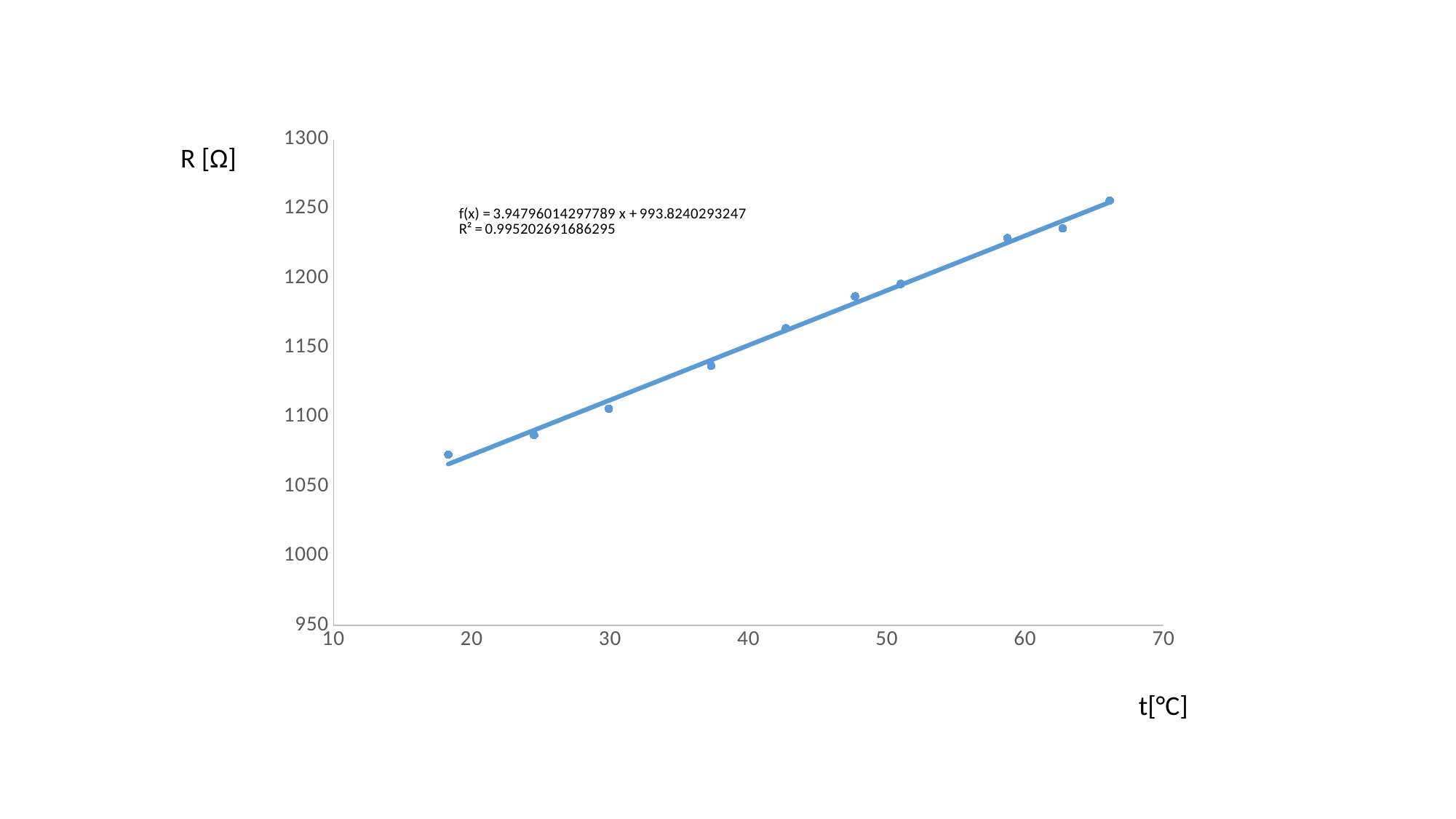
Is the R value of the rightmost data point greater or less than 1200? greater Is the R value of the data point near t = 30 °C greater or less than 1150? less Do the R values rise or fall as t increases along the x axis? rise How many data points are plotted on the chart? 10 Which has the larger R value: the data point near t = 25 °C or the data point near t = 59 °C? the point near t = 59 °C What is the R² value printed on the chart for the trendline? 0.995202691686295 What kind of chart is shown on the slide? scatter chart Is the R value of the data point near t = 51 °C greater or less than 1150? greater What is the label of the vertical axis? R [Ω] Does the highest R value occur at the lowest or the highest temperature plotted? highest temperature